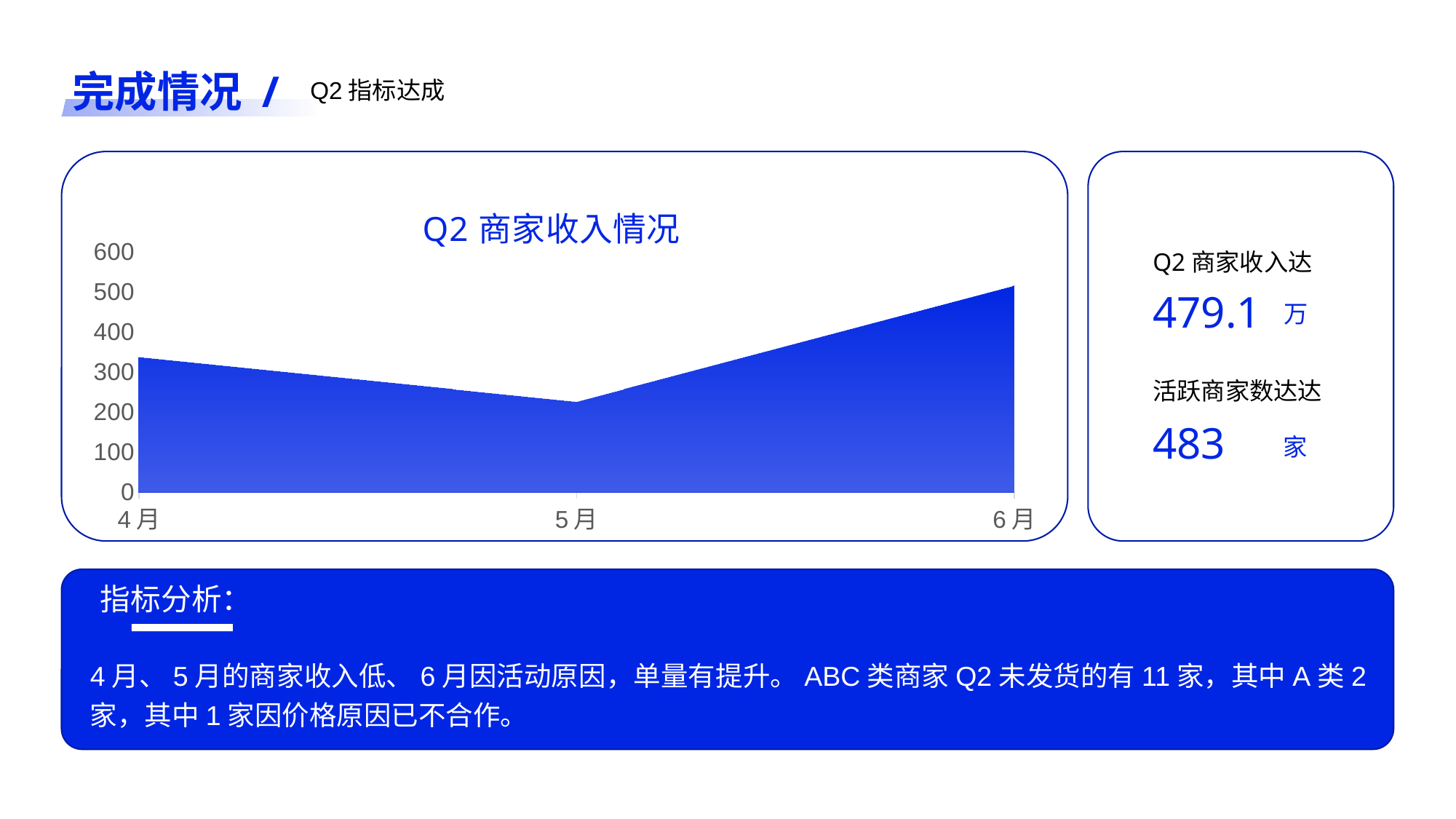
What kind of chart is shown on the slide? Area chart Which is larger in the chart, the value for 4月 or the value for 5月? 4月 Which month has the lowest value in the chart? 5月 Is the value for 4月 greater or less than 300? greater What are the category labels on the x axis of the chart? 4月, 5月, 6月 Is the value for 5月 greater or less than 300? less Is the value for 6月 greater or less than 400? greater What is the title of the chart? Q2 商家收入情况 Which month has the highest value in the chart? 6月 How many months are plotted on the x axis of the chart? 3 How do the values change from 4月 to 6月 in the chart? They fall from 4月 to 5月, then rise to 6月 Which is larger in the chart, the value for 6月 or the value for 4月? 6月